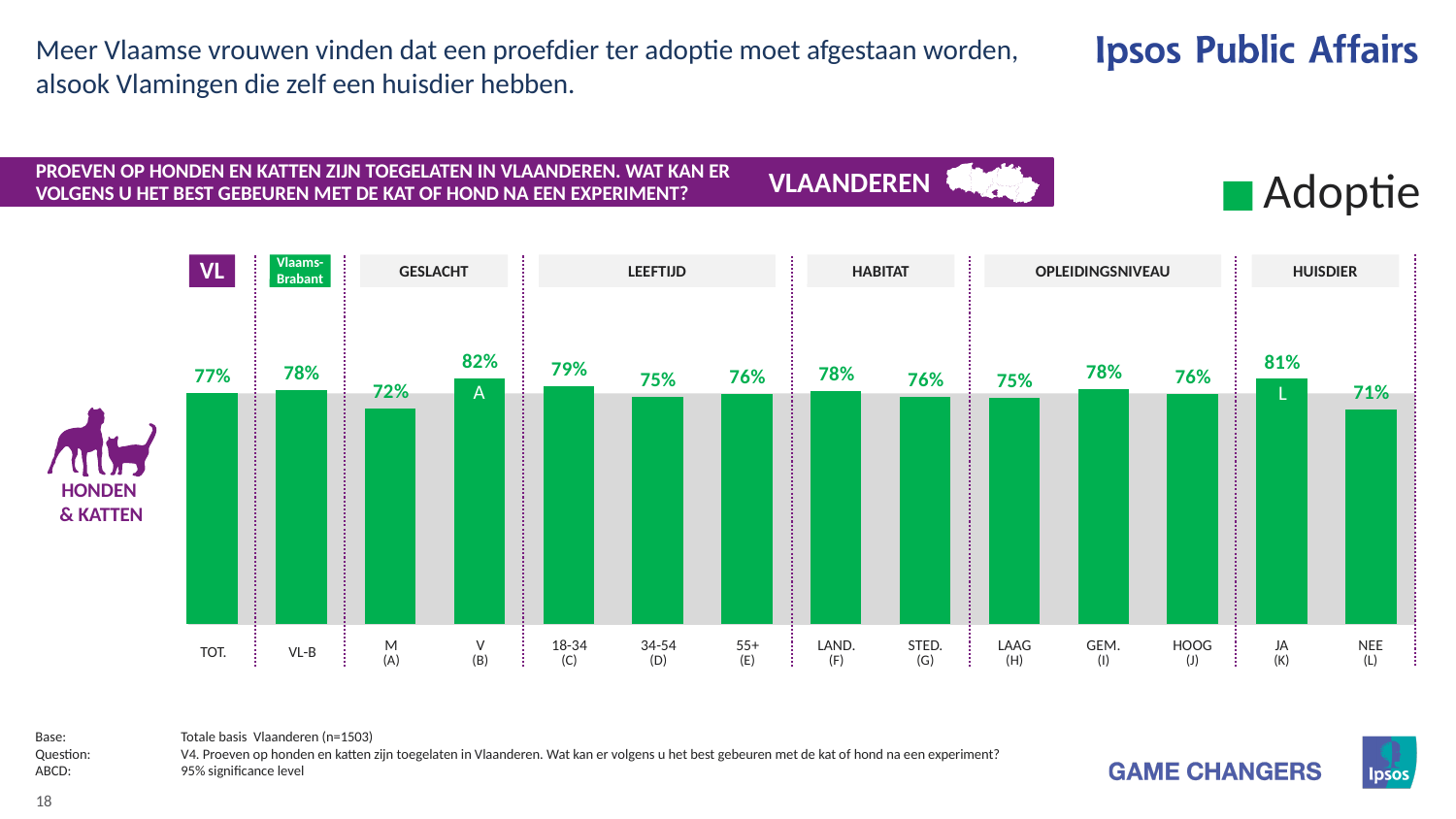
What is the value for TOT. (total Flanders)? 77% What is the value for the 18-34 age group? 79% What is the value for NEE in the HUISDIER group? 71% Which category has the lowest value on the chart? NEE (L) How many series does the legend list? 1 How many bars are plotted on the chart? 14 Which is larger, the value for JA or the value for NEE in the HUISDIER group? JA Which category has the highest value on the chart? V (B) What is the difference between the values for V and M in the GESLACHT group? 10% What is the value for V (women) in the GESLACHT group? 82% What kind of chart is shown on the slide? Bar chart What is the difference between the values for JA and NEE in the HUISDIER group? 10%